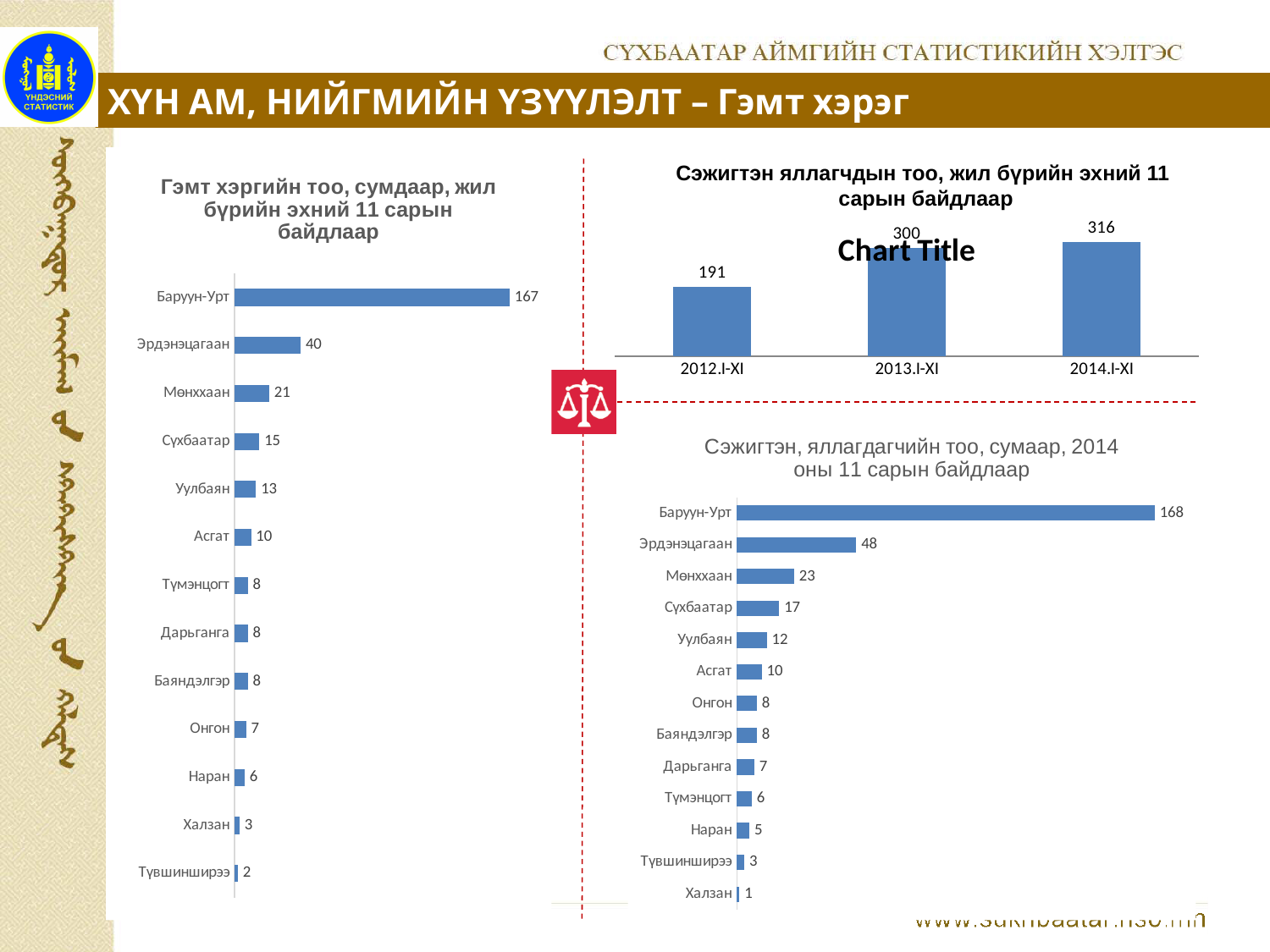
In the bottom-right chart titled "Сэжигтэн, яллагдагчийн тоо, сумаар, 2014 оны 11 сарын байдлаар", what is the value for Эрдэнэцагаан? 48 In the left chart titled "Гэмт хэргийн тоо, сумдаар, жил бүрийн эхний 11 сарын байдлаар", what is the difference between the values for Эрдэнэцагаан and Мөнххаан? 19 In the bottom-right chart titled "Сэжигтэн, яллагдагчийн тоо, сумаар, 2014 оны 11 сарын байдлаар", what is the value for Халзан? 1 In the left chart titled "Гэмт хэргийн тоо, сумдаар, жил бүрийн эхний 11 сарын байдлаар", which category has the lowest value? Түвшинширээ What kind of chart is the top-right chart titled "Сэжигтэн яллагчдын тоо, жил бүрийн эхний 11 сарын байдлаар"? bar chart In the top-right chart titled "Сэжигтэн яллагчдын тоо, жил бүрийн эхний 11 сарын байдлаар", do the values rise or fall from 2012.I-XI to 2014.I-XI? rise In the left chart titled "Гэмт хэргийн тоо, сумдаар, жил бүрийн эхний 11 сарын байдлаар", what is the value for Баруун-Урт? 167 In the left chart titled "Гэмт хэргийн тоо, сумдаар, жил бүрийн эхний 11 сарын байдлаар", how many categories are shown? 13 In the bottom-right chart titled "Сэжигтэн, яллагдагчийн тоо, сумаар, 2014 оны 11 сарын байдлаар", which is larger, the value for Сүхбаатар or the value for Уулбаян? Сүхбаатар In the top-right chart titled "Сэжигтэн яллагчдын тоо, жил бүрийн эхний 11 сарын байдлаар", what is the difference between the values for 2014.I-XI and 2012.I-XI? 125 In the top-right chart titled "Сэжигтэн яллагчдын тоо, жил бүрийн эхний 11 сарын байдлаар", what is the value for 2013.I-XI? 300 In the bottom-right chart titled "Сэжигтэн, яллагдагчийн тоо, сумаар, 2014 оны 11 сарын байдлаар", which category has the highest value? Баруун-Урт